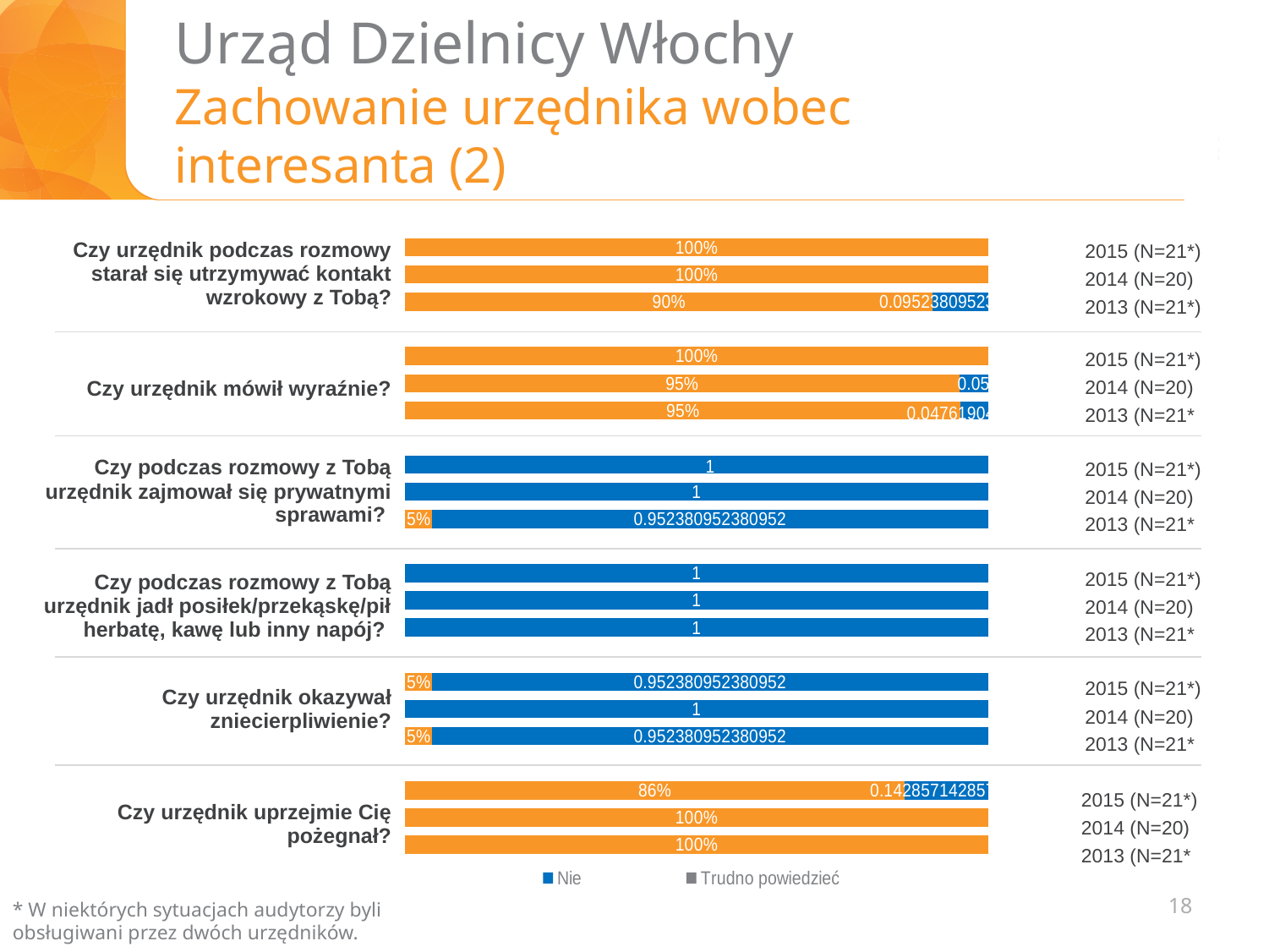
How many survey questions (row groups) are shown in the chart? 6 For the question "Czy urzędnik okazywał zniecierpliwienie?", what value is printed on the blue bar for 2014? 1 For the question "Czy urzędnik mówił wyraźnie?", what is the value of the orange segment for 2014? 95% For the question "Czy urzędnik uprzejmie Cię pożegnał?", what is the value of the orange segment for 2015? 86% For the question "Czy urzędnik podczas rozmowy starał się utrzymywać kontakt wzrokowy z Tobą?", what is the value of the orange segment for 2013? 90% For the question "Czy podczas rozmowy z Tobą urzędnik zajmował się prywatnymi sprawami?", what value is printed on the blue segment for 2013? 0.952380952380952 For the question "Czy urzędnik uprzejmie Cię pożegnał?", what is the difference between the orange values for 2014 and 2015? 14% For the question "Czy urzędnik mówił wyraźnie?", what value is printed on the blue segment for 2014? 0.05 For the question "Czy urzędnik mówił wyraźnie?", what is the value of the orange segment for 2015? 100% What sample size is given for 2014? N=20 For the question "Czy urzędnik uprzejmie Cię pożegnał?", which year has the larger orange segment, 2015 or 2014? 2014 What kind of chart is shown on the slide? bar chart